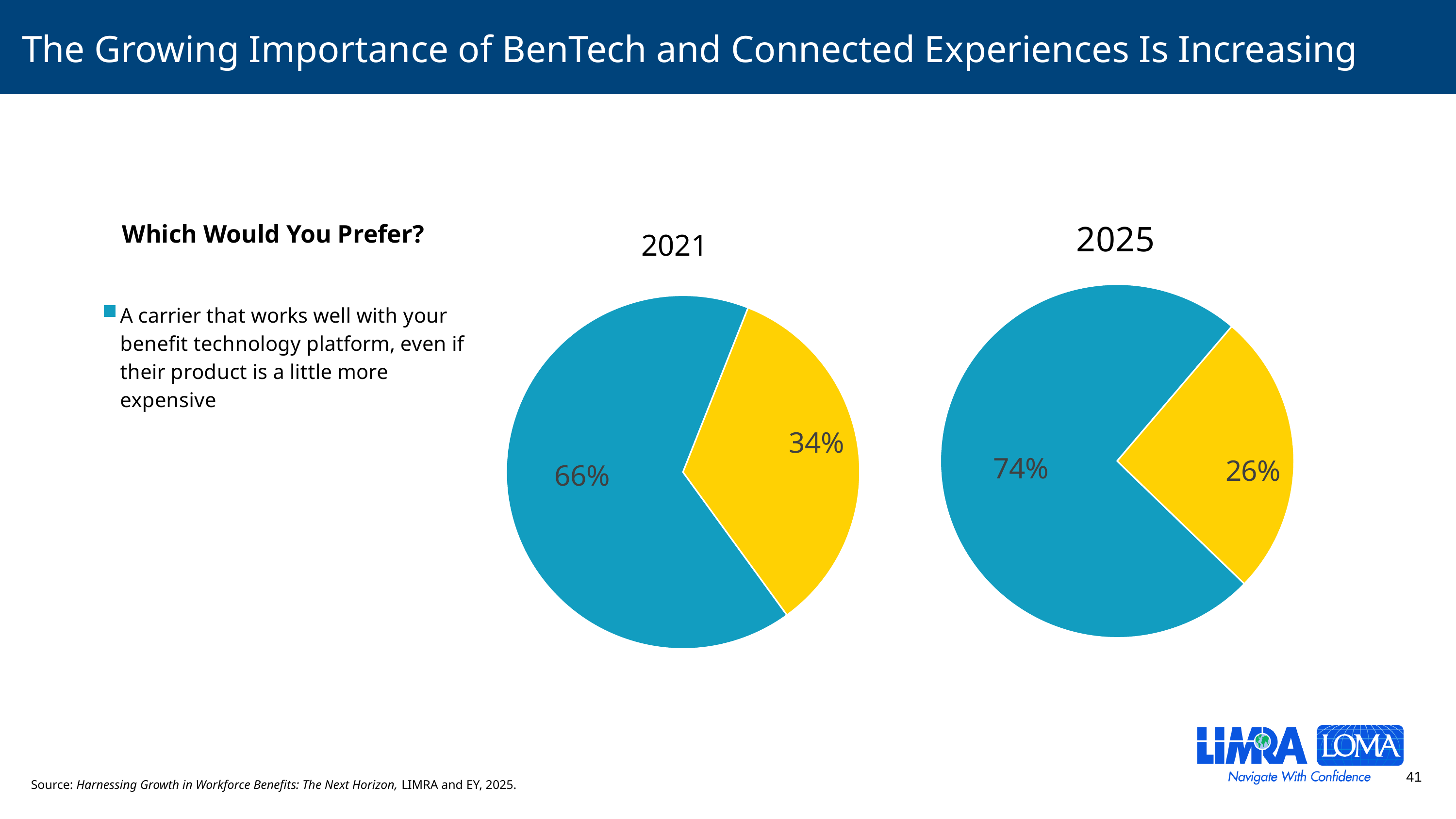
What is the title of the pie chart on the right? 2025 In the 2021 pie chart, what share is shown for the blue slice, 'A carrier that works well with your benefit technology platform, even if their product is a little more expensive'? 66% By how many percentage points did the blue slice ('A carrier that works well with your benefit technology platform...') grow from the 2021 pie chart to the 2025 pie chart? 8 percentage points In the 2025 pie chart, which slice is the smallest? The yellow slice (26%) In the 2021 pie chart, what is the difference between the blue slice and the yellow slice? 32 percentage points In the 2021 pie chart, what share is shown for the yellow slice? 34% Is the yellow slice larger in the 2021 pie chart or the 2025 pie chart? 2021 What type of chart is used on this slide? Pie chart In the 2021 pie chart, which slice is the largest? A carrier that works well with your benefit technology platform, even if their product is a little more expensive (66%) In the 2025 pie chart, what share is shown for the blue slice, 'A carrier that works well with your benefit technology platform, even if their product is a little more expensive'? 74% In the 2025 pie chart, what share is shown for the yellow slice? 26% How many slices does the 2025 pie chart have? 2